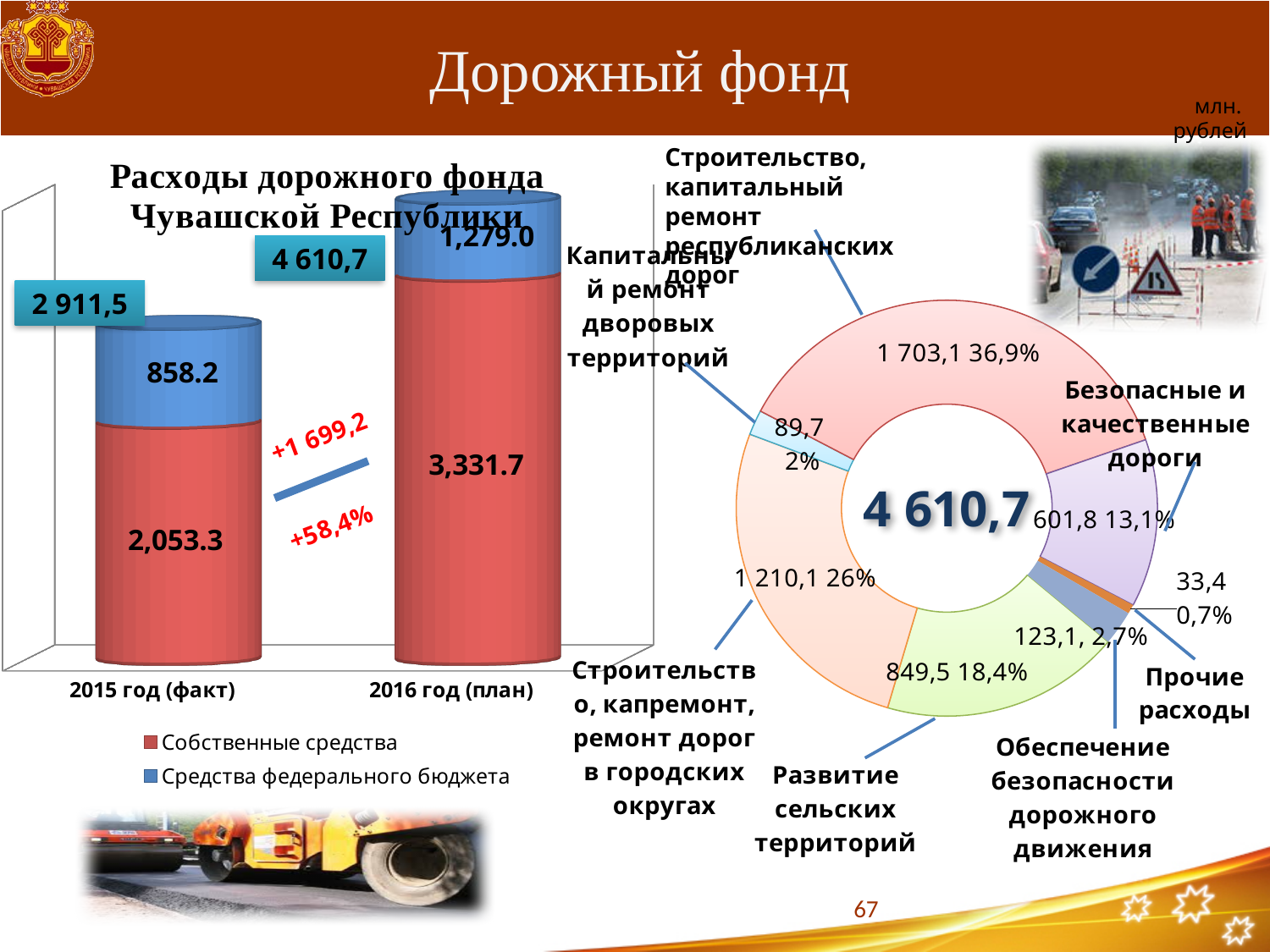
In the bar chart 'Расходы дорожного фонда Чувашской Республики', what is the difference between 'Собственные средства' in 2016 год (план) and in 2015 год (факт)? 1,278.4 In the bar chart 'Расходы дорожного фонда Чувашской Республики', how many series does the legend list? 2 In the donut chart on the right, which category has the smallest value? Прочие расходы In the bar chart 'Расходы дорожного фонда Чувашской Республики', which series is shown in red? Собственные средства In the donut chart on the right, which is larger: 'Строительство, капремонт, ремонт дорог в городских округах' or 'Развитие сельских территорий'? Строительство, капремонт, ремонт дорог в городских округах In the donut chart on the right, what share does 'Безопасные и качественные дороги' have? 13,1% In the donut chart on the right, what value is shown for 'Развитие сельских территорий'? 849,5 In the bar chart 'Расходы дорожного фонда Чувашской Республики', what is the total of the stacked bar for '2015 год (факт)'? 2 911,5 In the bar chart 'Расходы дорожного фонда Чувашской Республики', what is the value of 'Средства федерального бюджета' for '2016 год (план)'? 1,279.0 In the bar chart 'Расходы дорожного фонда Чувашской Республики', what is the total of the stacked bar for '2016 год (план)'? 4 610,7 What kind of chart is the chart on the right side of the slide with '4 610,7' in the centre? Donut (pie) chart In the bar chart 'Расходы дорожного фонда Чувашской Республики', what is the value of 'Собственные средства' for '2015 год (факт)'? 2,053.3